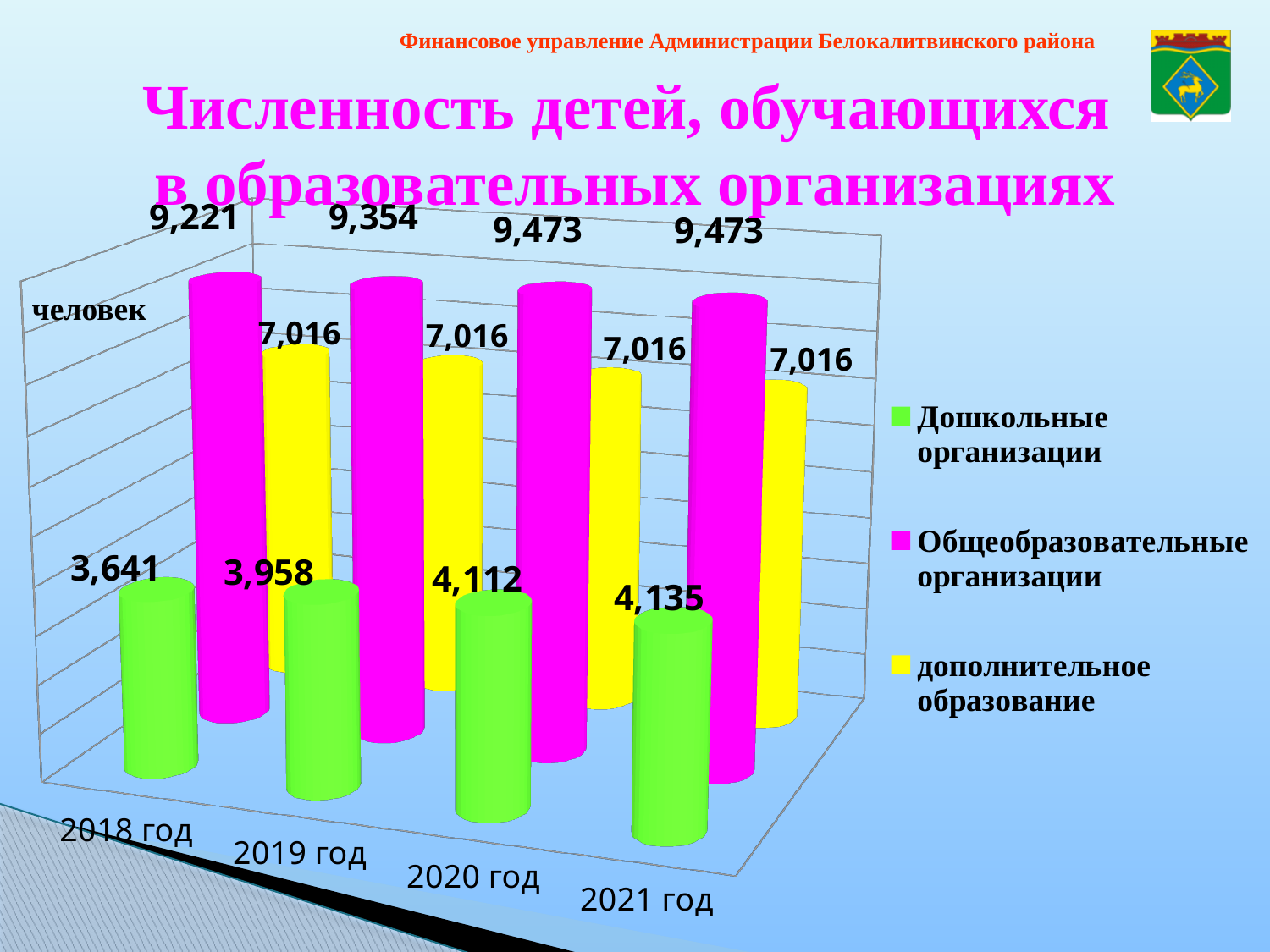
What is the value for Дошкольные организации in 2018 год? 3,641 What is the value for Общеобразовательные организации in 2020 год? 9,473 What is the difference between the Общеобразовательные организации values for 2019 год and 2018 год? 133 What kind of chart is shown on the slide? bar chart Which is larger in 2019 год: Общеобразовательные организации or дополнительное образование? Общеобразовательные организации What is the difference between the Дошкольные организации values for 2021 год and 2018 год? 494 How many series does the legend list? 3 In which year is the value for Общеобразовательные организации lowest? 2018 год In which year is the value for Дошкольные организации highest? 2021 год Do the values for Дошкольные организации rise or fall from 2018 год to 2021 год? rise What is the value for дополнительное образование in 2021 год? 7,016 How many years are shown on the x axis? 4